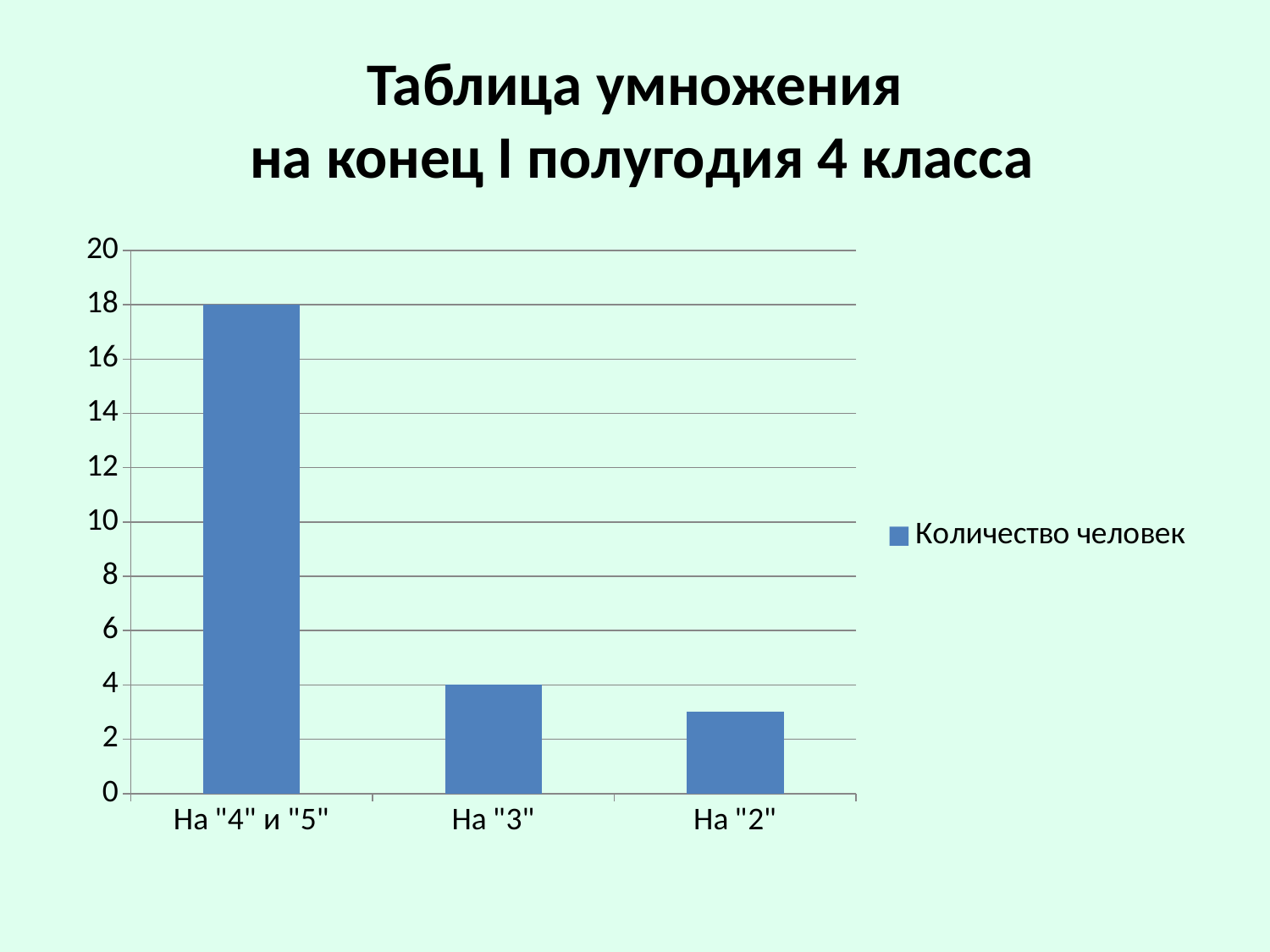
How many categories are shown on the x axis? 3 What kind of chart is shown on the slide? bar chart Is the value for На "2" greater or less than 2? greater What is the value for На "3"? 4 What is the value for На "4" и "5"? 18 Which category has the lowest value? На "2" Which is larger, the value for На "3" or the value for На "2"? На "3" What is the difference between the values for На "4" и "5" and На "3"? 14 Which category has the highest value? На "4" и "5" How many series does the legend list? 1 What is the name of the series in the legend? Количество человек Is the value for На "2" greater or less than 4? less